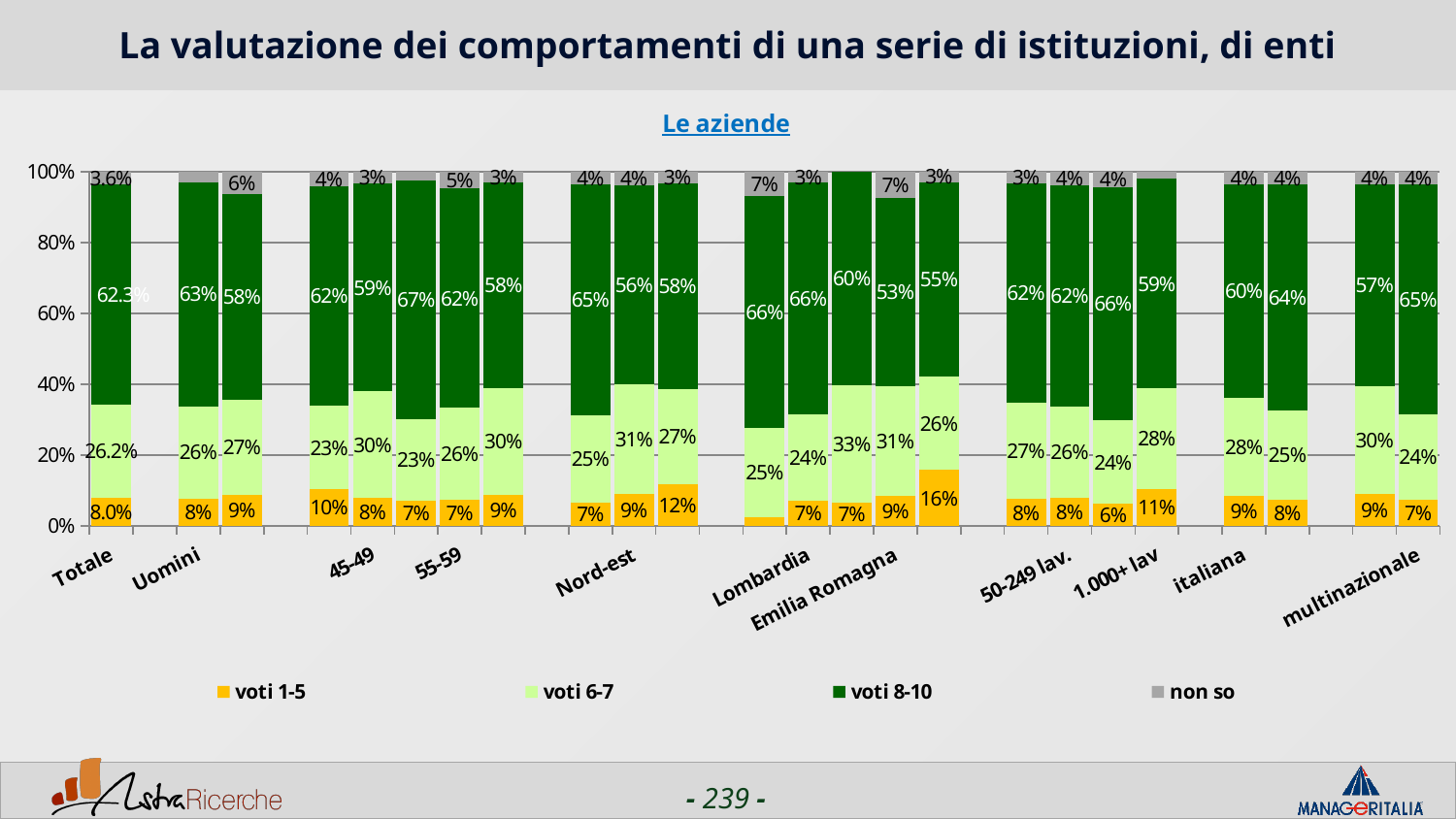
What is the subtitle shown above the chart? Le aziende What is the value of 'voti 8-10' for Uomini? 63% What kind of chart is shown on the slide? Stacked bar chart In the Totale bar, which series has the largest share? voti 8-10 What is the value of 'voti 6-7' for the Totale bar? 26.2% In the Totale bar, which is larger: 'voti 6-7' or 'voti 1-5'? voti 6-7 What is the value of 'voti 1-5' for the Totale bar? 8.0% What is the value of 'non so' for the Totale bar? 3.6% What is the value of 'voti 8-10' for the Totale bar? 62.3% How many series does the legend list? 4 What is the value of 'voti 1-5' for Uomini? 8% What is the difference between 'voti 8-10' and 'voti 6-7' in the Totale bar? 36.1 percentage points